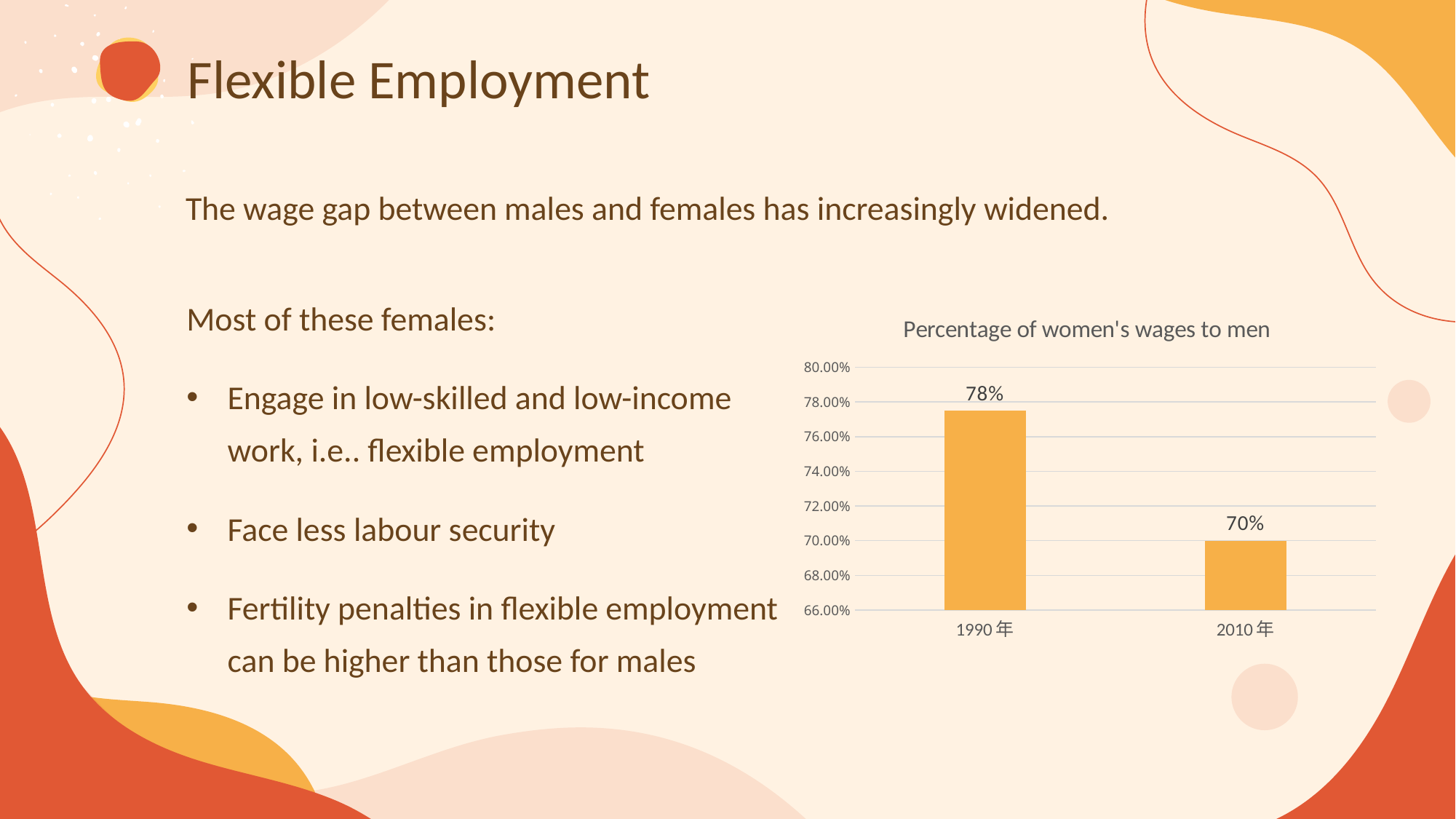
Which is larger, the value for 1990年 or the value for 2010年? 1990年 What is the title of the chart? Percentage of women's wages to men What is the difference between the values for 1990年 and 2010年? 8% Which year has the lowest percentage of women's wages to men? 2010年 Which year has the highest percentage of women's wages to men? 1990年 What is the value for 2010年 in the chart? 70% What kind of chart is shown on the slide? bar chart Do the values rise or fall from 1990年 to 2010年? fall How many categories are shown on the x axis of the chart? 2 What is the value for 1990年 in the chart? 78% Is the value for 2010年 greater or less than 74.00%? less Is the value for 1990年 greater or less than 76.00%? greater